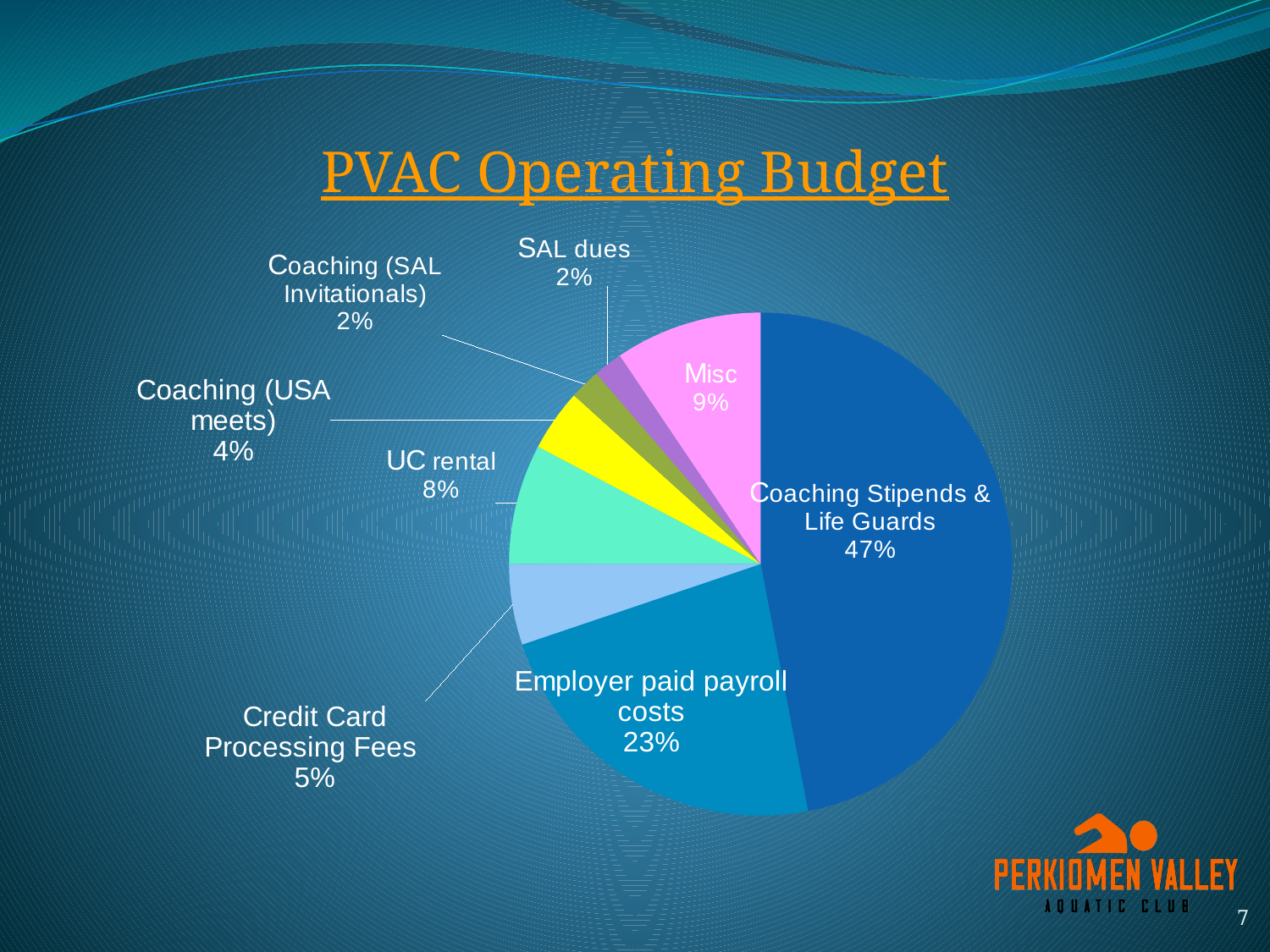
What percentage of the budget is Employer paid payroll costs? 23% What is the difference in percentage points between Coaching Stipends & Life Guards and Employer paid payroll costs? 24 Which is larger, the share for UC rental or the share for Misc? Misc What percentage is shown for Credit Card Processing Fees? 5% How many slices does the pie chart have? 8 Which category takes the largest share of the budget? Coaching Stipends & Life Guards What share of the budget is Misc? 9% What share of the budget is UC rental? 8% What share of the budget goes to Coaching Stipends & Life Guards? 47% What is the title of the chart? PVAC Operating Budget What kind of chart is shown on the slide? Pie chart What percentage of the budget is Coaching (USA meets)? 4%